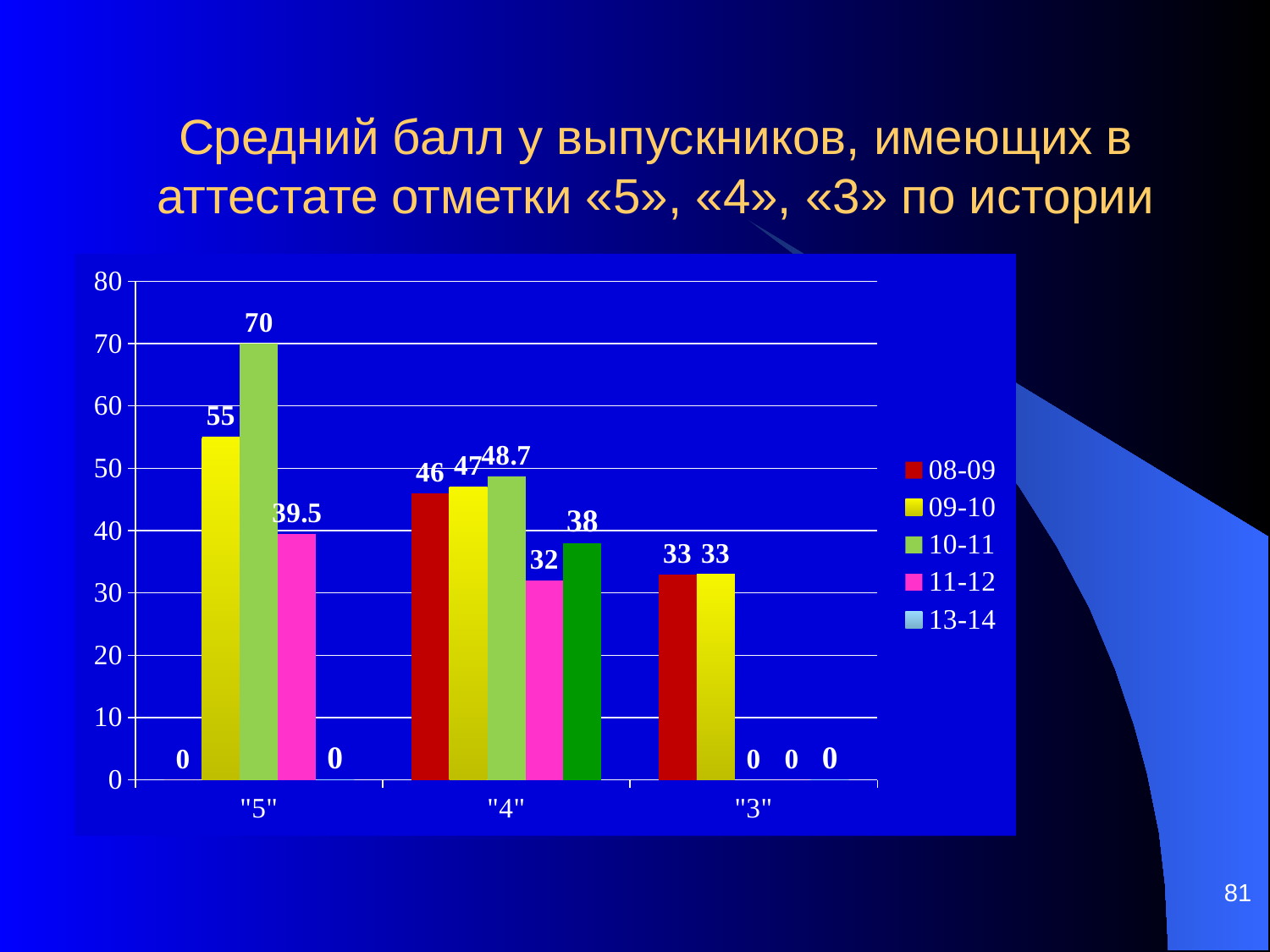
In the "4" category, which is larger: the 09-10 value or the 11-12 value? 09-10 How many categories are shown on the x axis? 3 What is the difference between the 10-11 and 09-10 values in the "5" category? 15 What is the value for the 10-11 series in the "5" category? 70 In which category is the 10-11 series highest? "5" What is the value for the 11-12 series in the "5" category? 39.5 What is the difference between the 08-09 and 11-12 values in the "4" category? 14 How many series does the legend list? 5 What kind of chart is shown on the slide? bar chart What is the value for the 08-09 series in the "3" category? 33 What is the value for the 11-12 series in the "4" category? 32 What is the value for the 09-10 series in the "5" category? 55